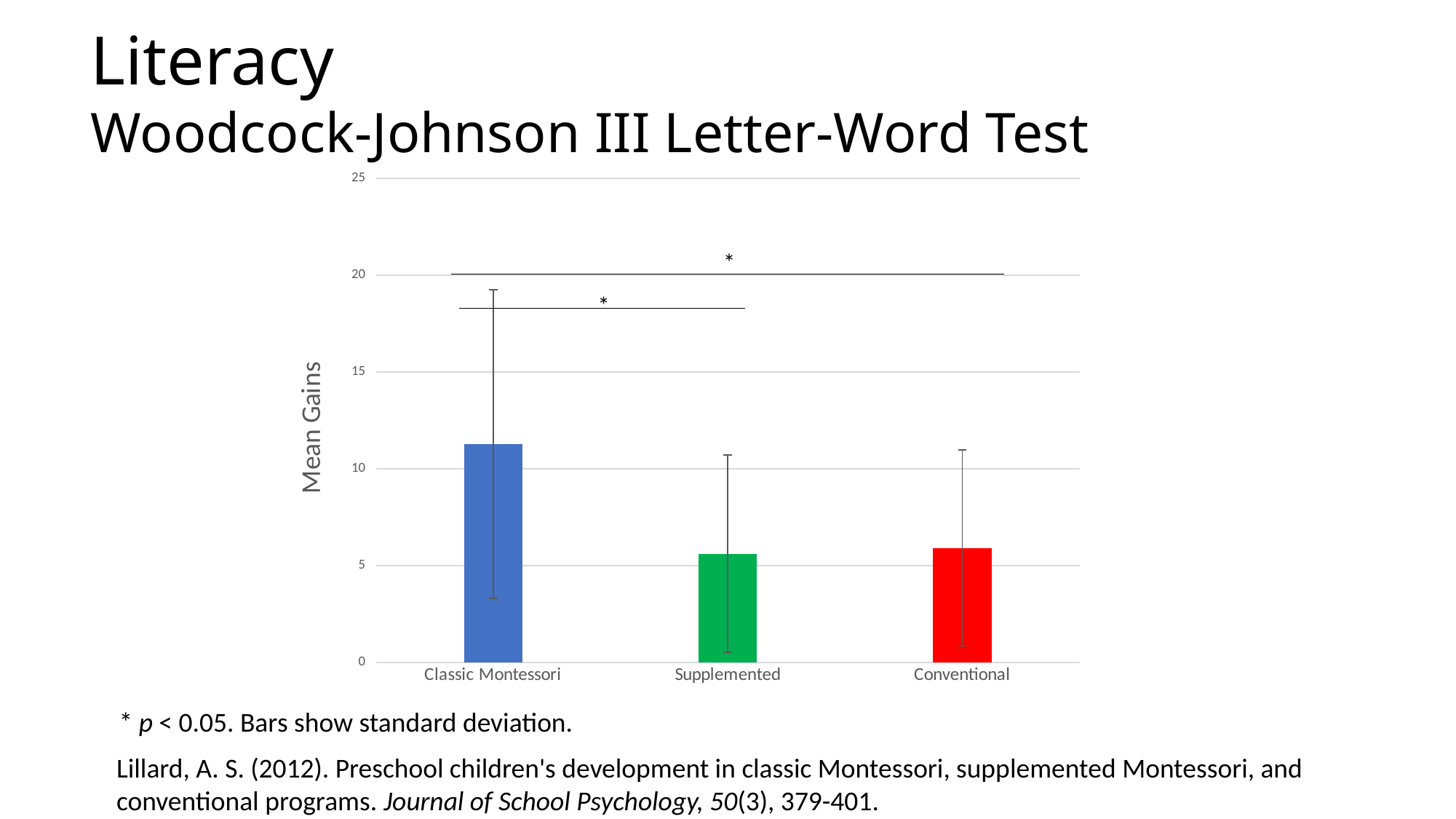
How many categories are plotted on the x axis of the chart? 3 Is the value for Classic Montessori greater or less than 15? less Which is larger, the value for Conventional or the value for Classic Montessori? Classic Montessori Is the value for Conventional greater or less than 10? less What colour is the bar for Classic Montessori? blue Which is larger, the value for Classic Montessori or the value for Supplemented? Classic Montessori Is the value for Supplemented greater or less than 10? less What is the label on the y axis of the chart? Mean Gains What kind of chart is shown on the slide? bar chart Which category has the highest mean gain? Classic Montessori